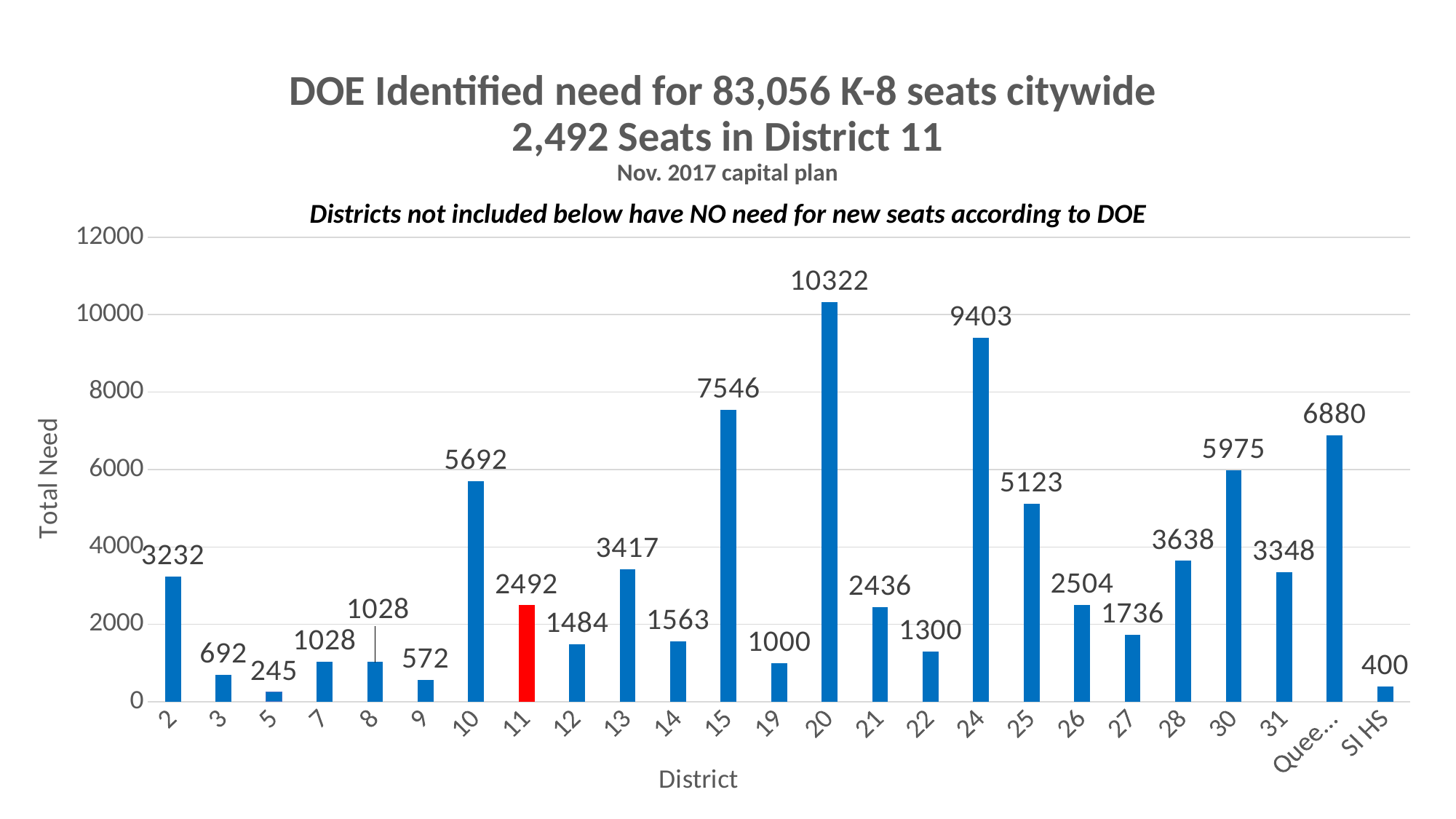
What is the total need for District 20? 10322 Which has a larger total need, District 15 or District 30? District 15 What is the total need for SI HS? 400 Which district has the highest total need? 20 What kind of chart is shown on the slide? bar chart What is the difference in total need between District 11 and District 12? 1008 What is the total need for District 11? 2492 Is the value for District 10 greater or less than 4000? greater What is the difference in total need between District 20 and District 24? 919 Which district has the lowest total need? 5 How many districts are shown on the x axis? 25 Which district's bar is coloured red? 11